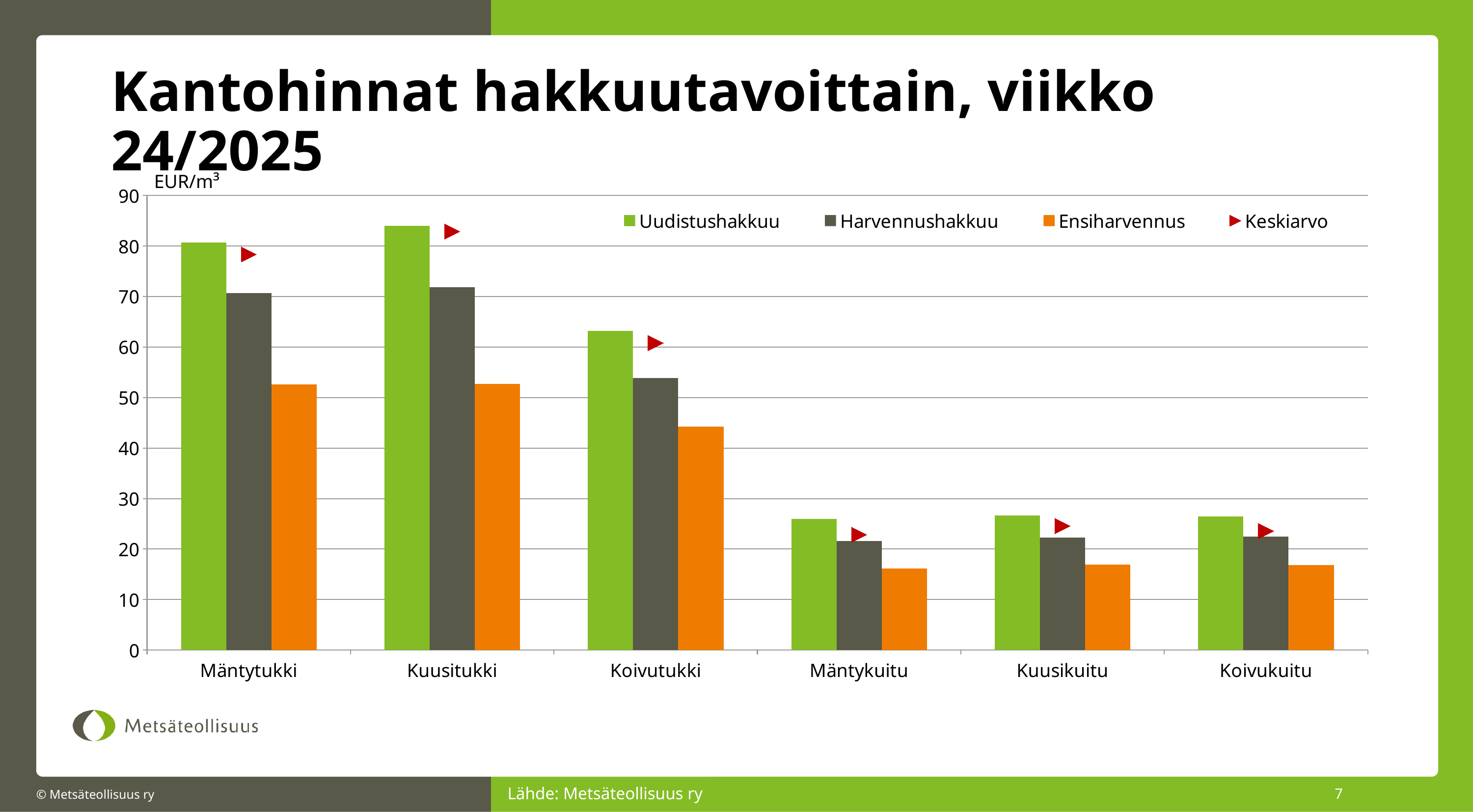
Which category has the highest Uudistushakkuu value? Kuusitukki Which is larger: the Uudistushakkuu value for Mäntytukki or for Kuusitukki? Kuusitukki How many categories are shown on the x axis? 6 How many series does the legend list? 4 Is the Harvennushakkuu value for Mäntytukki greater or less than 60? greater Which is larger for Koivutukki: the Harvennushakkuu value or the Ensiharvennus value? Harvennushakkuu Is the Ensiharvennus value for Mäntykuitu greater or less than 20? less What unit is shown on the y axis of the chart? EUR/m³ Is the Ensiharvennus value for Koivutukki greater or less than 40? greater Which category has the lowest Harvennushakkuu value among the three tukki categories (Mäntytukki, Kuusitukki, Koivutukki)? Koivutukki What kind of chart is shown on the slide? bar chart